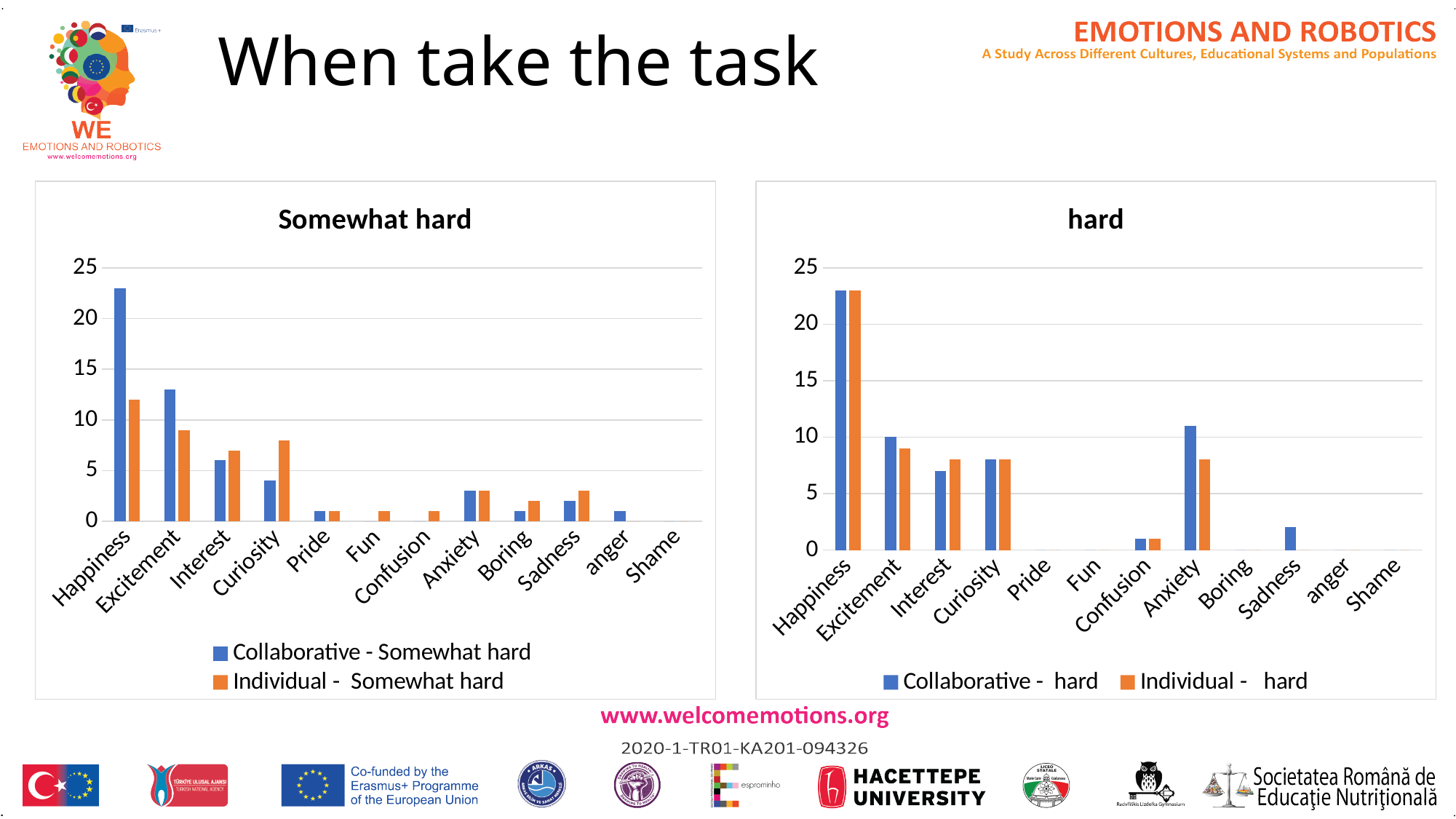
In the 'Somewhat hard' chart, is the Individual value for Excitement greater or less than 10? less In the 'Somewhat hard' chart, is the Collaborative value for Happiness greater or less than 20? greater What are the two legend entries of the 'hard' chart? Collaborative - hard; Individual - hard In the 'hard' chart, is the Collaborative value for Anxiety greater or less than 10? greater What kind of chart is the 'Somewhat hard' chart? bar chart In the 'Somewhat hard' chart, which is larger for Curiosity, the Collaborative value or the Individual value? Individual In the 'hard' chart, which is larger for Anxiety, the Collaborative value or the Individual value? Collaborative How many categories are shown on the x axis of the 'hard' chart? 12 How many series does the legend of the 'Somewhat hard' chart list? 2 In the 'Somewhat hard' chart, which category has the highest Collaborative value? Happiness In the 'hard' chart, which category has the highest Individual value? Happiness